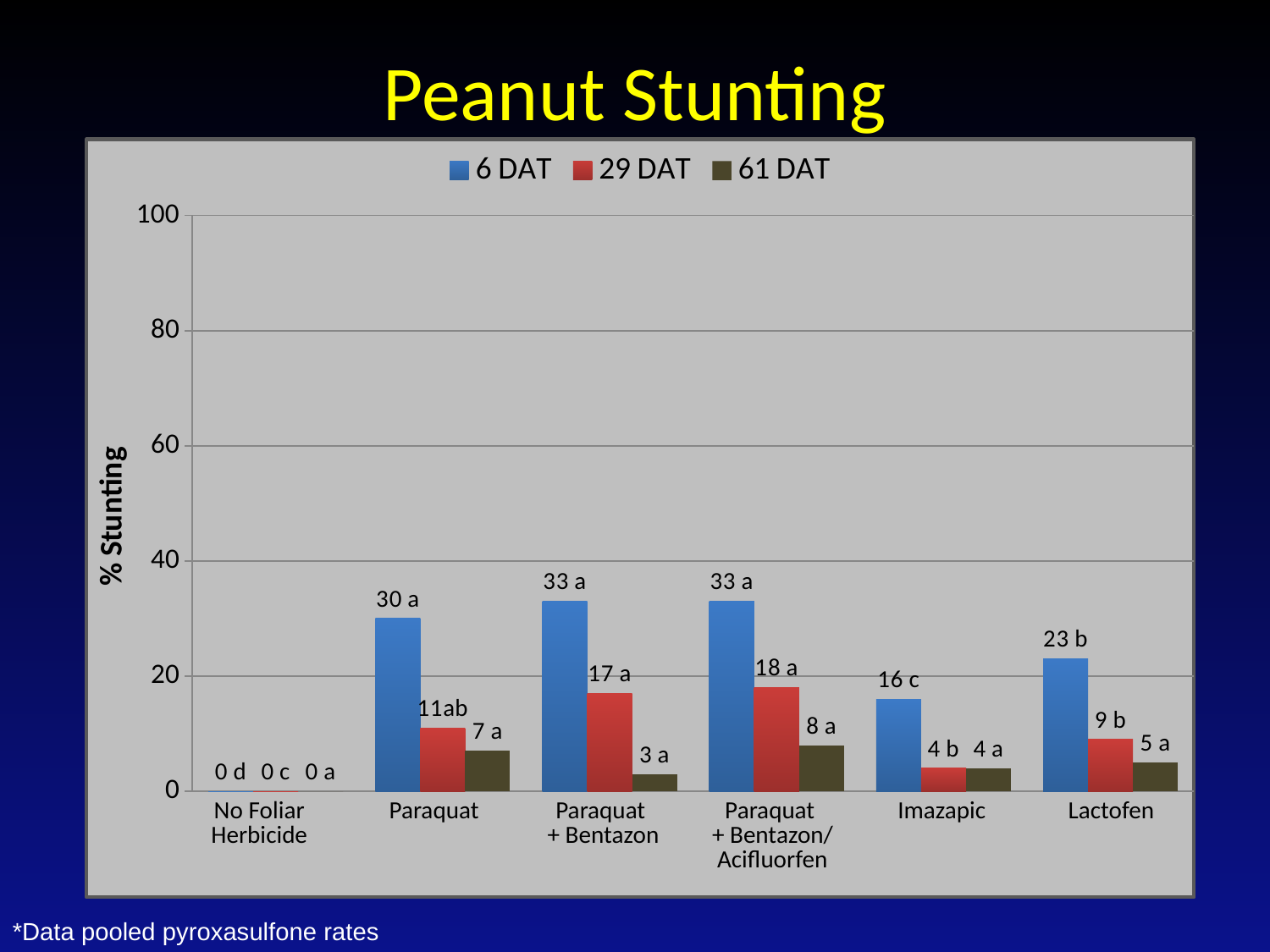
Which treatment has the lowest 6 DAT value? No Foliar Herbicide How many series does the legend list? 3 What is the 61 DAT value for Lactofen? 5 a What is the 6 DAT value for Paraquat? 30 a What kind of chart is shown? bar chart Is the 6 DAT value for Imazapic greater or less than 20? less Which is larger, the 61 DAT value for Paraquat or the 61 DAT value for Paraquat + Bentazon? Paraquat Which treatment has the highest 29 DAT value? Paraquat + Bentazon/Acifluorfen How many treatment categories are shown on the x axis? 6 What is the 29 DAT value for Paraquat + Bentazon/Acifluorfen? 18 a What is the label of the y axis? % Stunting What is the difference between the 6 DAT values for Paraquat + Bentazon and Lactofen? 10